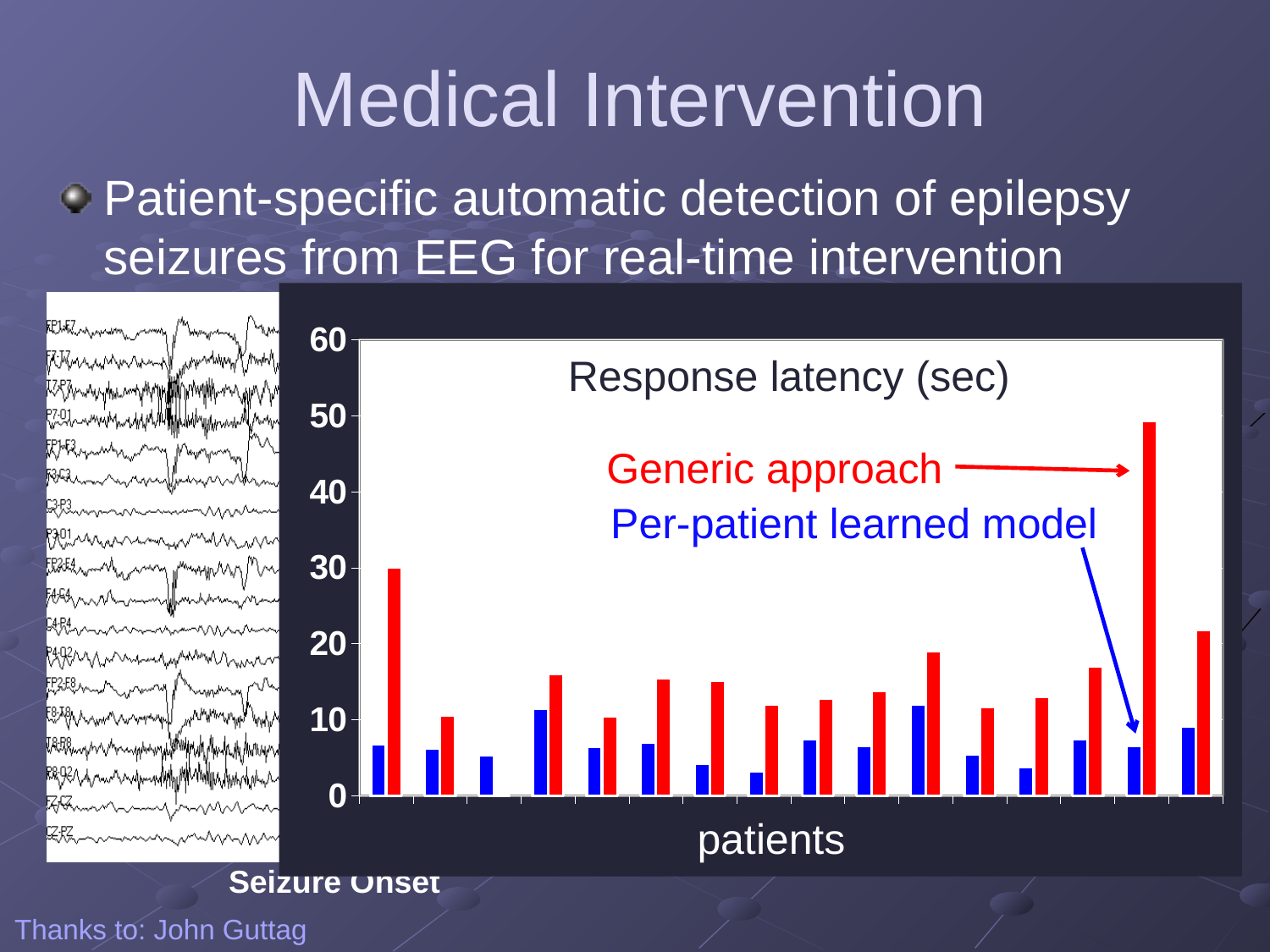
Is the lowest value for the Generic approach series greater or less than 20? less What is the title of the chart? Response latency (sec) What kind of chart is shown on the slide? bar chart How many series does the chart show? 2 Is the highest value for the Generic approach series greater or less than 40? greater Which series generally shows the higher response latency, Generic approach or Per-patient learned model? Generic approach Is the highest value for the Per-patient learned model series greater or less than 20? less What is the highest tick value shown on the y axis? 60 Which series contains the tallest bar in the chart? Generic approach What is the label on the x axis of the chart? patients